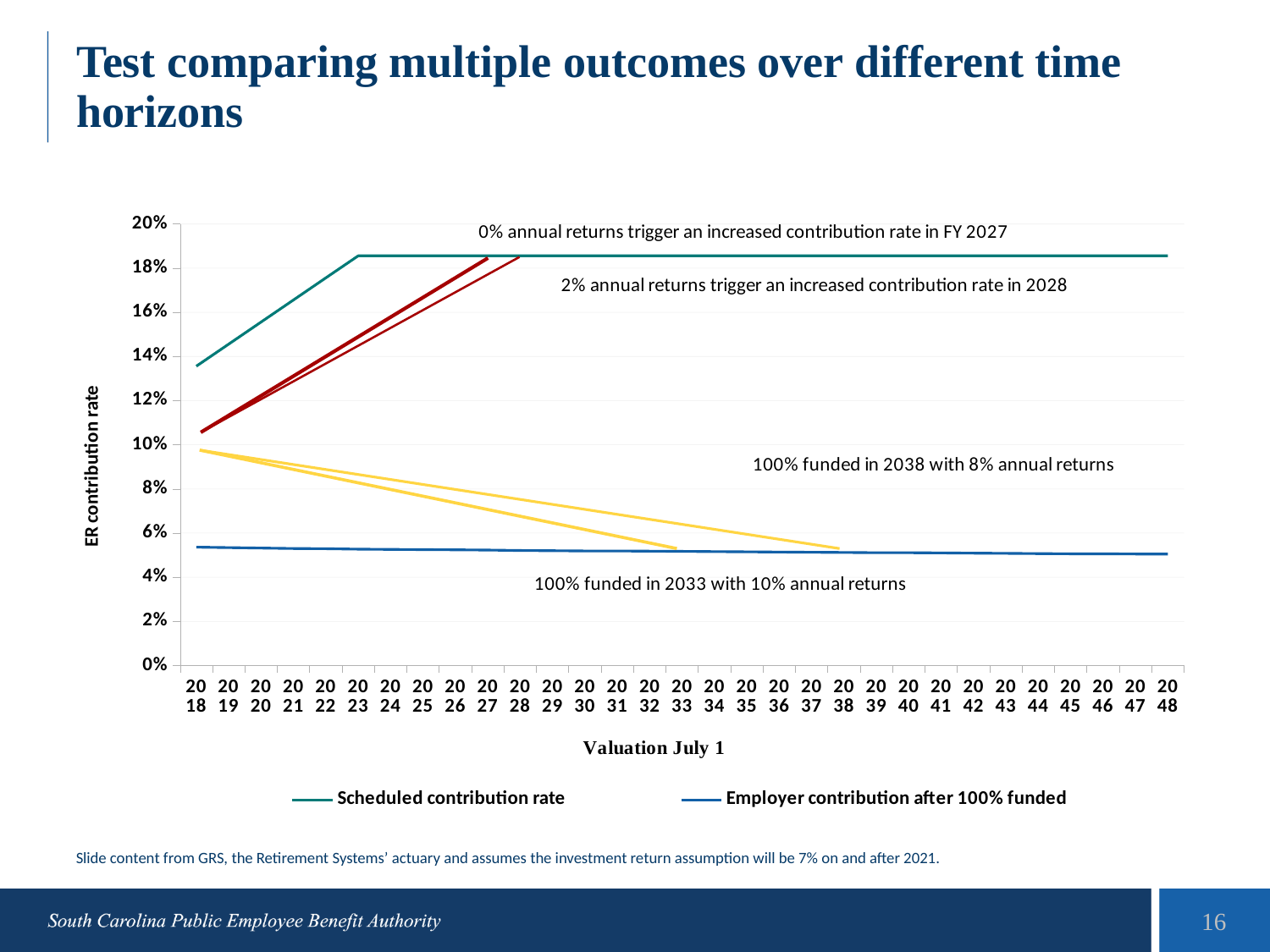
Is the value of the Employer contribution after 100% funded in 2018 greater or less than 8%? less In 2030, which series has the higher value: Scheduled contribution rate or Employer contribution after 100% funded? Scheduled contribution rate How many years are shown along the x axis of the chart? 31 Is the value of the Scheduled contribution rate in 2040 greater or less than 18%? greater Is the value of the Scheduled contribution rate in 2018 greater or less than 12%? greater What is the label on the y axis of the chart? ER contribution rate What kind of chart is shown on the slide? Line chart What is the title of the x axis of the chart? Valuation July 1 Does the Scheduled contribution rate rise or fall between 2018 and 2023? rise How many series does the chart legend list? 2